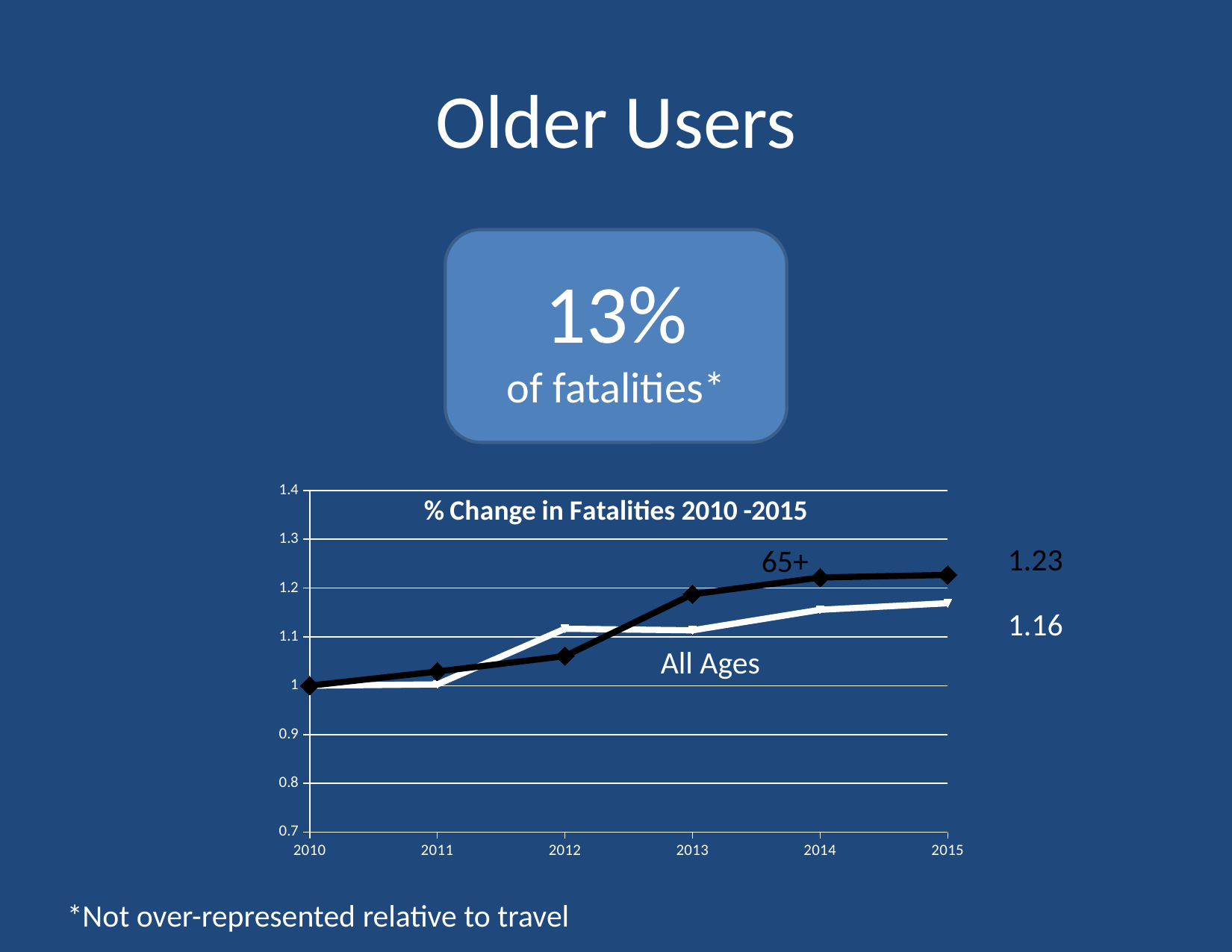
What kind of chart is shown on the slide? line chart What is the value for the All Ages series in 2015? 1.16 In 2015, which series has the higher value, 65+ or All Ages? 65+ What is the difference between the 65+ value and the All Ages value in 2015? 0.07 What is the value for the 65+ series in 2015? 1.23 Does the 65+ series rise or fall from 2010 to 2015? rise In 2012, which series has the higher value, 65+ or All Ages? All Ages How many series are plotted on the chart? 2 How many years are plotted on the x axis? 6 Is the value for 65+ in 2013 greater or less than 1.1? greater What is the title of the chart? % Change in Fatalities 2010 -2015 Is the value for 65+ in 2012 greater or less than 1.1? less